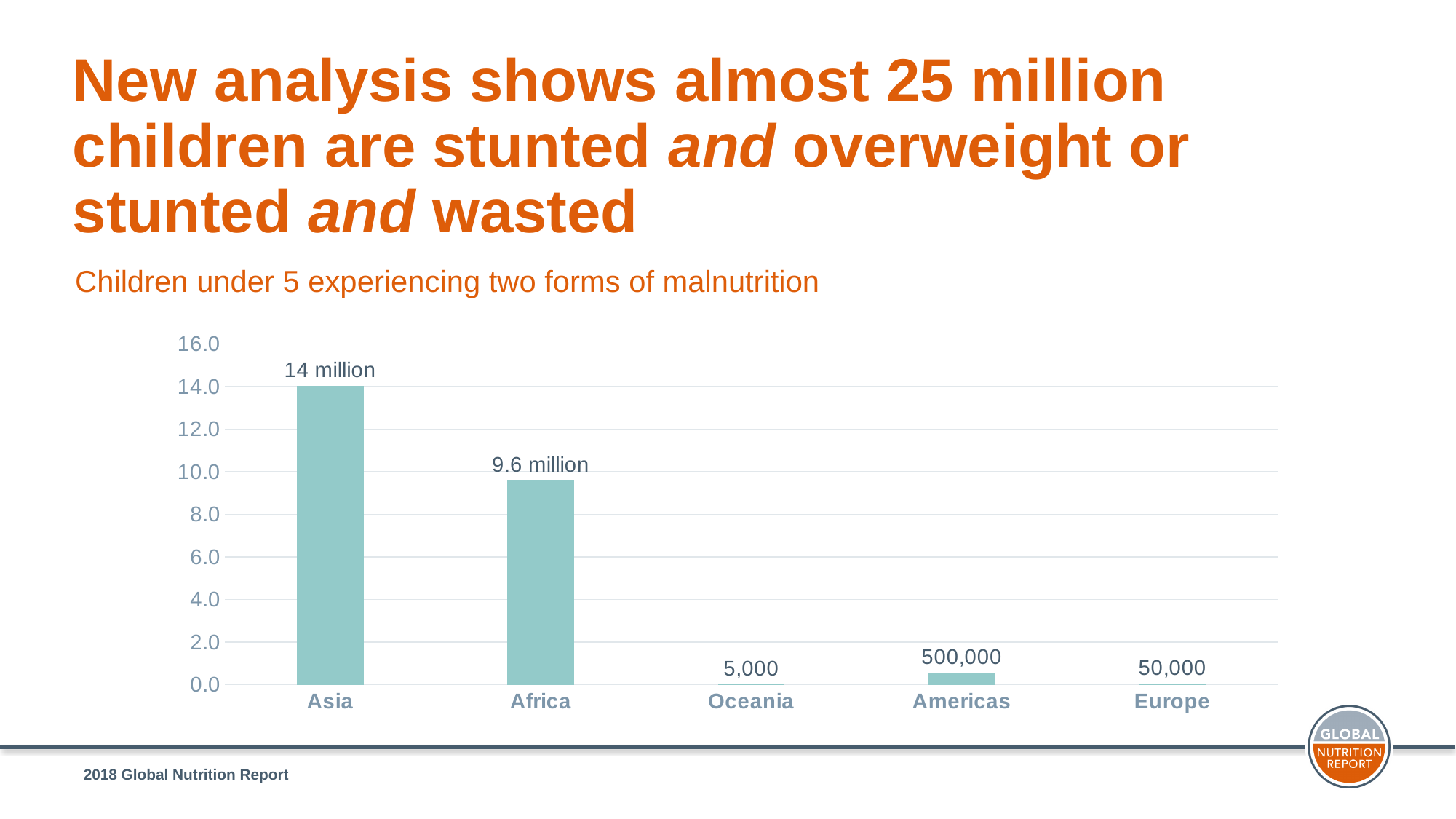
What is the value for Oceania? 5,000 What is the difference between the values for Asia and Africa? 4.4 million What is the value for Africa? 9.6 million Which region has the highest value? Asia What kind of chart is shown on the slide? Bar chart How many regions are shown on the x axis? 5 What is the difference between the values for the Americas and Europe? 450,000 What is the value for the Americas? 500,000 Which is larger, the value for Africa or the value for the Americas? Africa What is the value for Europe? 50,000 Which region has the lowest value? Oceania What is the value for Asia? 14 million